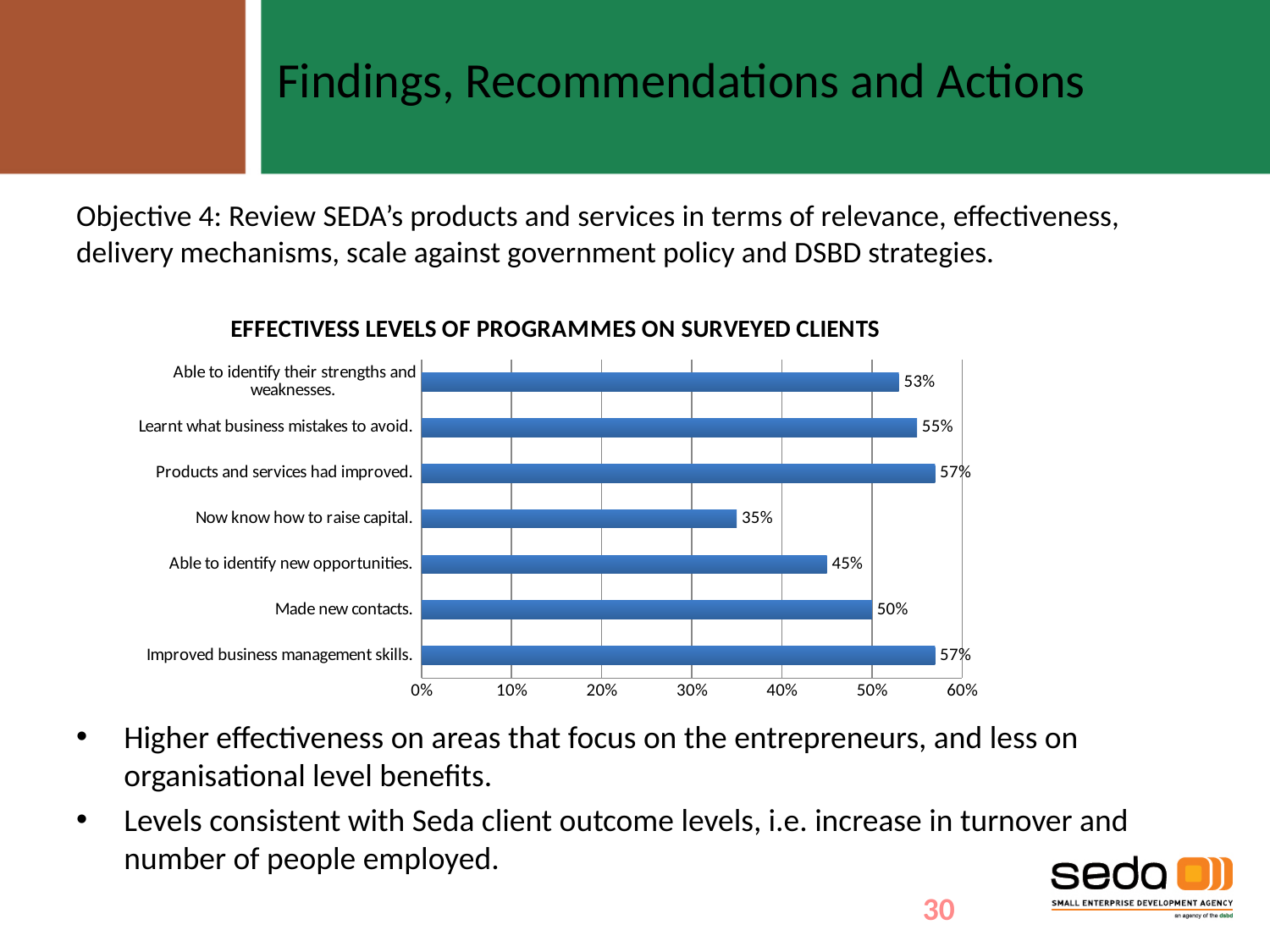
What is the value for 'Improved business management skills.'? 57% Which category has the lowest effectiveness level? Now know how to raise capital. What is the value for 'Able to identify their strengths and weaknesses.'? 53% What is the value for 'Made new contacts.'? 50% Is the value for 'Able to identify new opportunities.' greater or less than 40%? greater What percentage of surveyed clients said they learnt what business mistakes to avoid? 55% What kind of chart is shown on the slide? Bar chart What percentage of surveyed clients reported they now know how to raise capital? 35% Which is larger: the value for 'Learnt what business mistakes to avoid.' or the value for 'Made new contacts.'? Learnt what business mistakes to avoid. What is the title of the chart? EFFECTIVESS LEVELS OF PROGRAMMES ON SURVEYED CLIENTS What is the difference between the value for 'Products and services had improved.' and the value for 'Now know how to raise capital.'? 22 percentage points How many categories are shown in the chart? 7